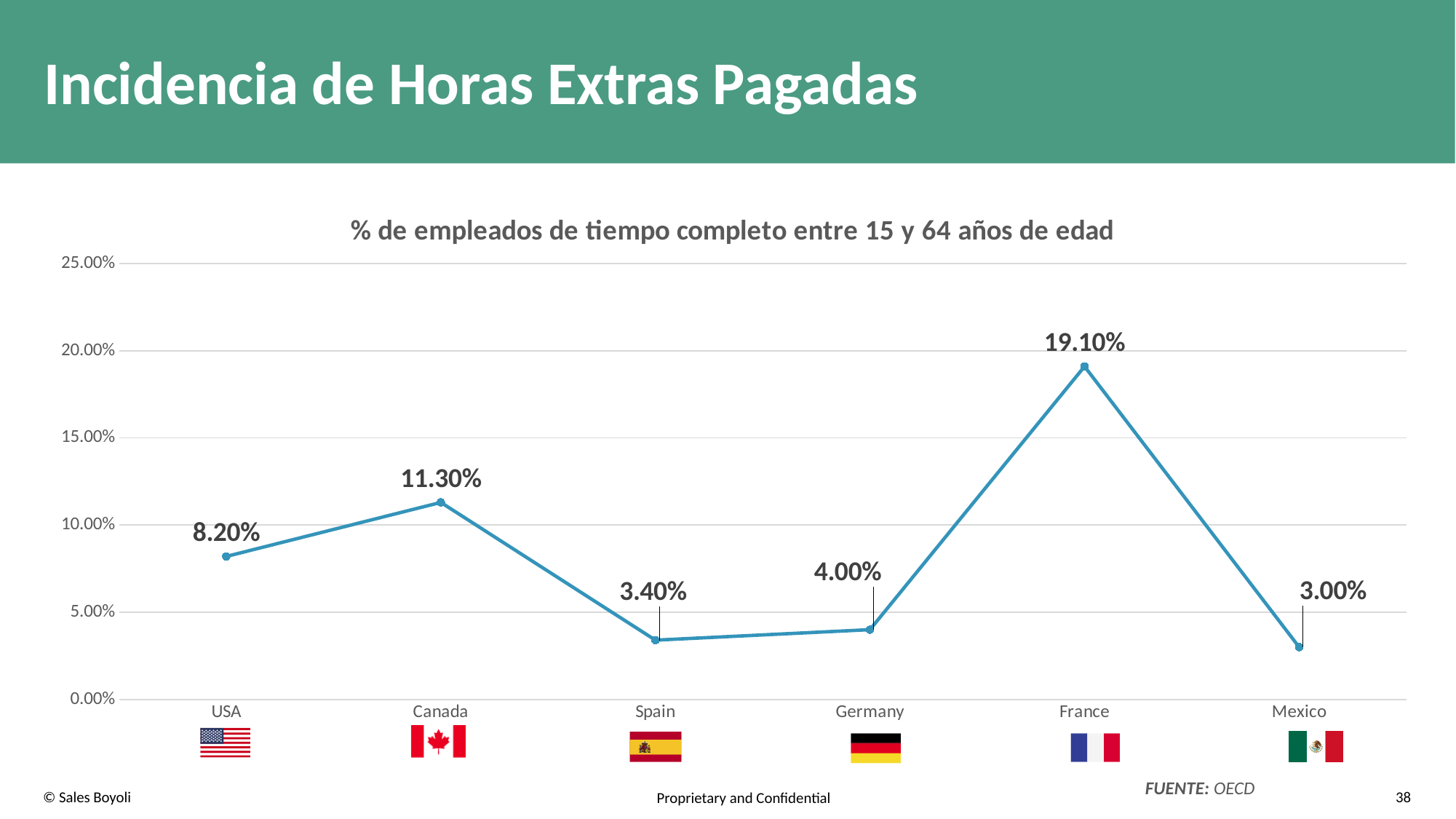
Which country has the lowest value? Mexico What is the value for Canada? 11.30% Which country has the highest value? France What is the title of the chart? % de empleados de tiempo completo entre 15 y 64 años de edad Which has a larger value, Spain or Germany? Germany Is the value for USA greater or less than 10.00%? less What kind of chart is shown on the slide? Line chart What is the value for Mexico? 3.00% How many countries are plotted on the chart? 6 What is the difference between the values for USA and Mexico? 5.20% What is the difference between the values for France and Canada? 7.80% What is the value for France? 19.10%